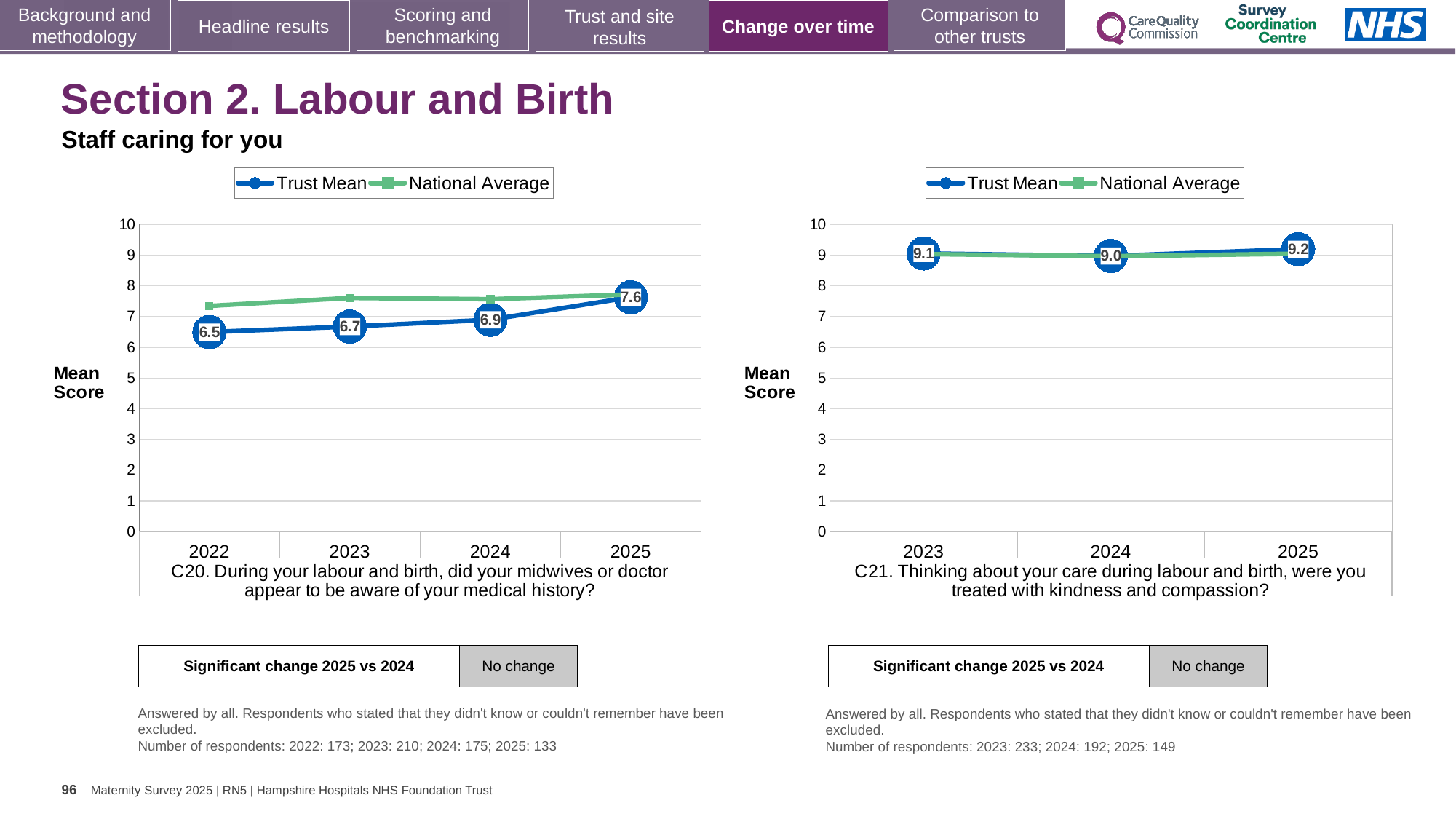
In the C20 chart (left), what is the Trust Mean score for 2022? 6.5 What kind of chart is the C20 chart (left)? Line chart In the C21 chart (right), what is the Trust Mean score for 2024? 9.0 In the C21 chart (right), which is larger, the Trust Mean for 2023 or for 2025? 2025 In the C20 chart (left), does the Trust Mean rise or fall from 2022 to 2025? Rise How many series does the legend of the C20 chart (left) list? 2 In the C20 chart (left), what is the Trust Mean score for 2025? 7.6 In the C21 chart (right), which year has the lowest Trust Mean score? 2024 How many years are shown on the x axis of the C21 chart (right)? 3 In the C20 chart (left), is the National Average for 2022 greater or less than 7? greater In the C20 chart (left), which year has the highest Trust Mean score? 2025 In the C20 chart (left), what is the difference between the Trust Mean scores for 2025 and 2022? 1.1